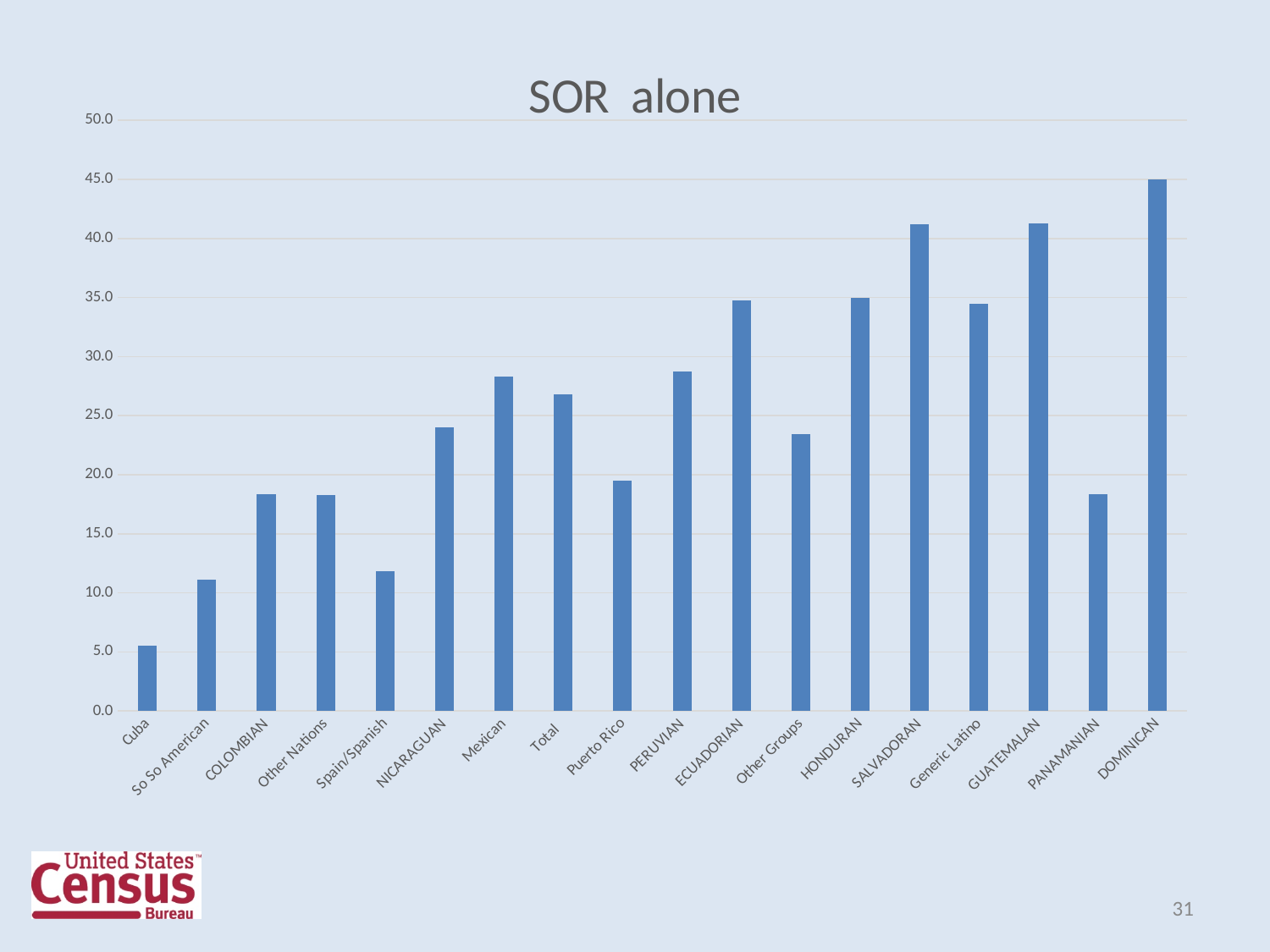
Which category has the highest bar? DOMINICAN How many categories are plotted on the x axis? 18 What is the title of the chart? SOR alone Which category has the lowest bar? Cuba Is the value for Mexican greater or less than 25.0? greater Which is larger, the value for SALVADORAN or the value for HONDURAN? SALVADORAN Which is larger, the value for Mexican or the value for Puerto Rico? Mexican Is the value for ECUADORIAN greater or less than 30.0? greater What kind of chart is shown on the slide? bar chart Is the value for PANAMANIAN greater or less than 20.0? less